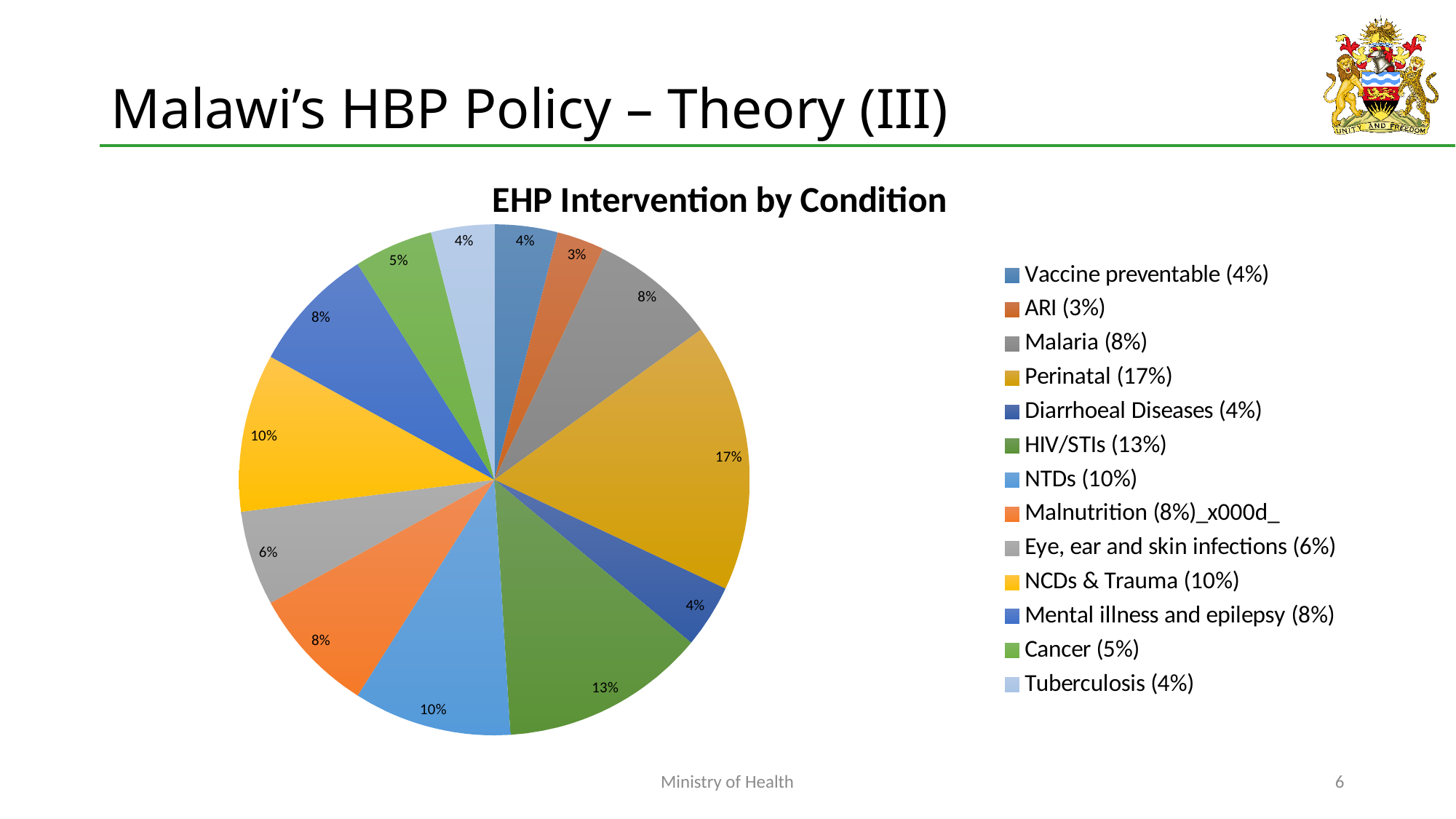
What type of chart is shown on the slide? Pie chart How many conditions are listed in the legend? 13 What is the combined share of NTDs and NCDs & Trauma? 20% What is the title of the chart? EHP Intervention by Condition Which condition has the smallest slice of the pie? ARI Which is larger, the share for Malaria or the share for Eye, ear and skin infections? Malaria What share of the pie does Perinatal account for? 17% What percentage is shown for ARI? 3% What percentage is shown for Cancer? 5% What percentage is shown for HIV/STIs? 13% What is the difference in percentage points between Perinatal and HIV/STIs? 4 Which condition has the largest slice of the pie? Perinatal